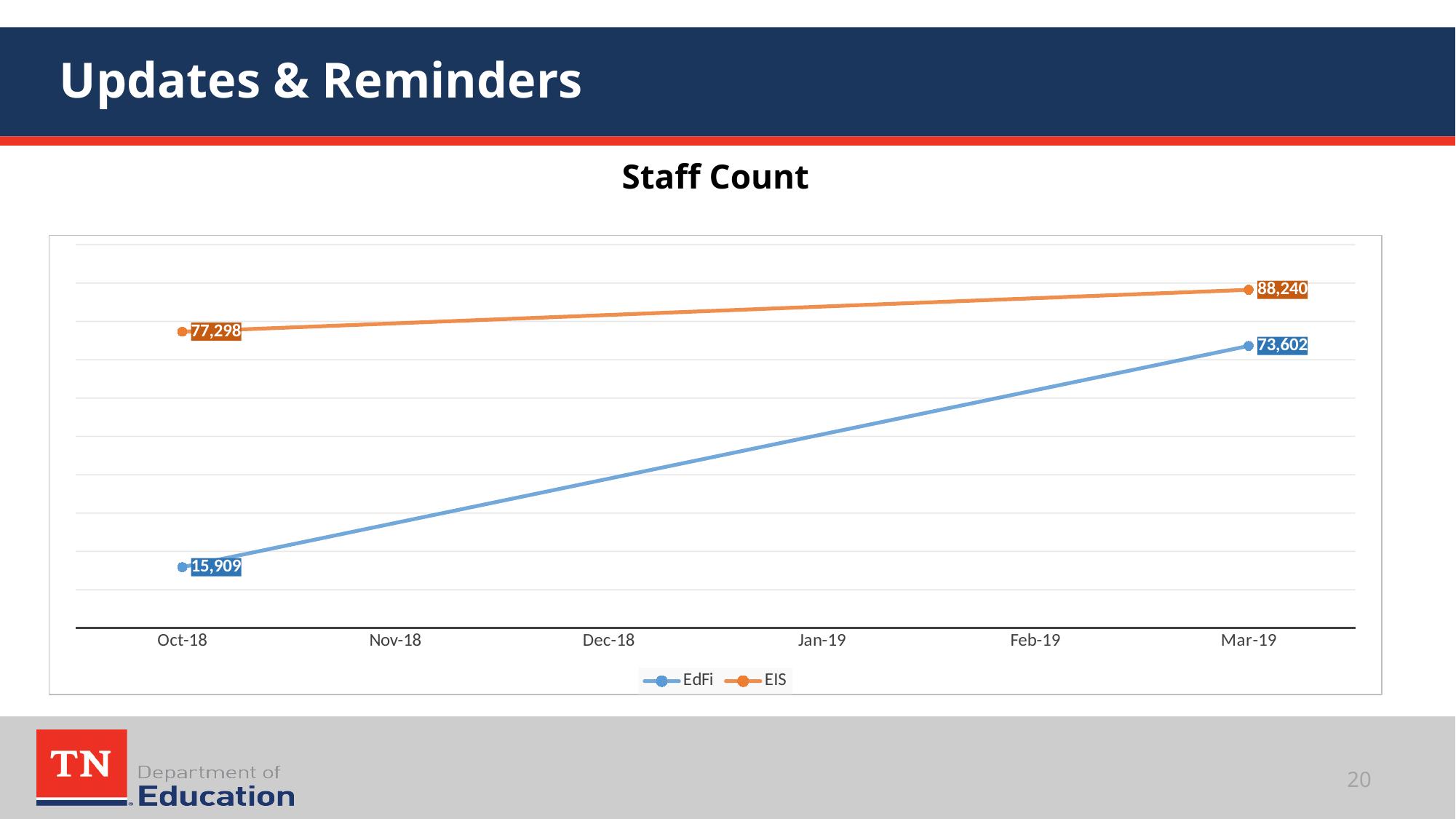
How many month labels are shown on the x axis? 6 What is the title of the chart? Staff Count What is the EIS staff count for Mar-19? 88,240 How many series does the legend list? 2 What is the EdFi staff count for Mar-19? 73,602 What is the EIS staff count for Oct-18? 77,298 By how much did the EdFi staff count increase from Oct-18 to Mar-19? 57,693 What is the difference between the EIS and EdFi staff counts in Mar-19? 14,638 What is the EdFi staff count for Oct-18? 15,909 What type of chart is shown on the slide? line chart Which series has the higher value in Mar-19, EdFi or EIS? EIS Does the EdFi series rise or fall from Oct-18 to Mar-19? rise